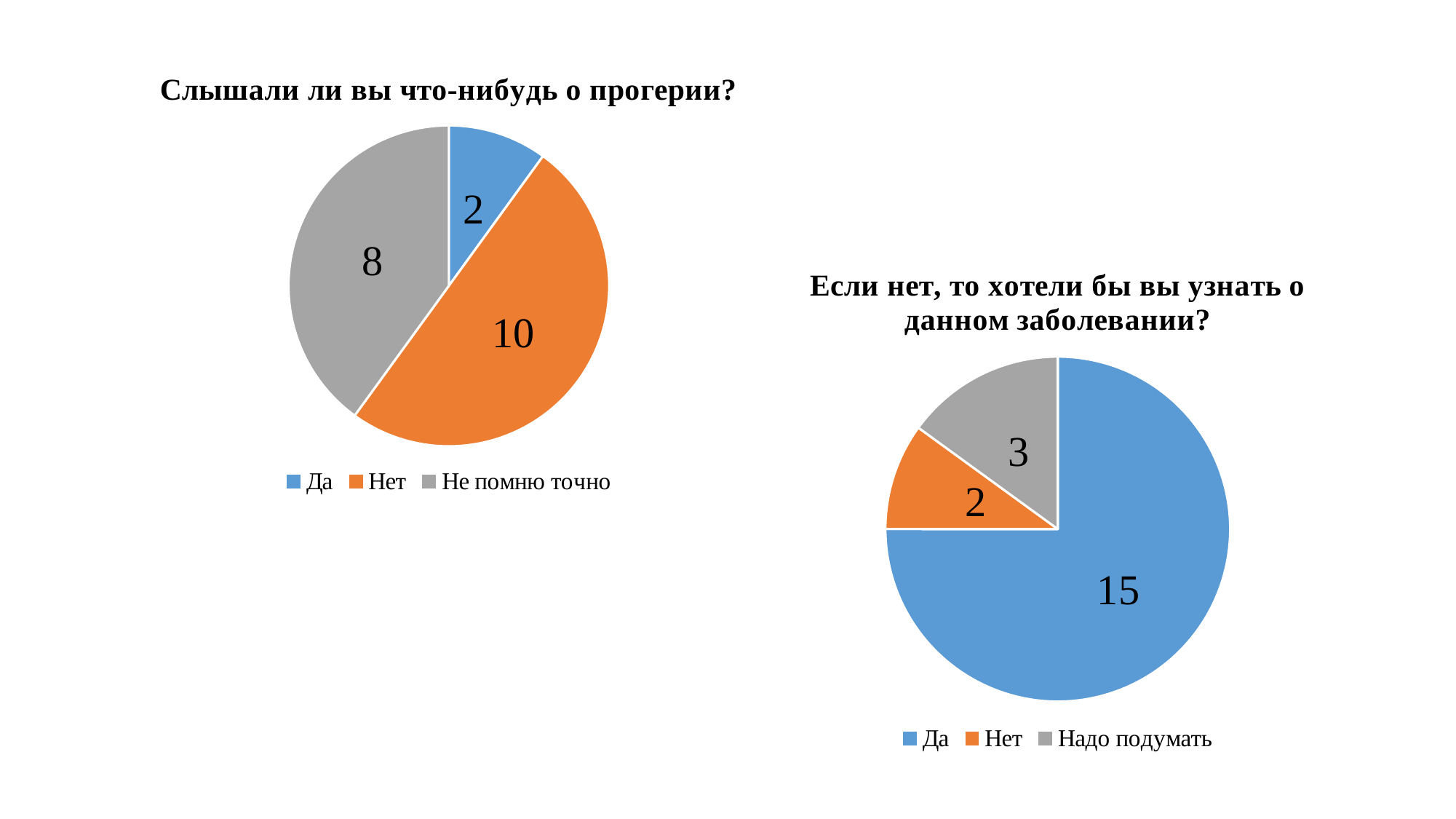
In the right chart titled "Если нет, то хотели бы вы узнать о данном заболевании?", what is the value for "Да"? 15 In the left chart titled "Слышали ли вы что-нибудь о прогерии?", what is the value for "Нет"? 10 What kind of chart is the right chart titled "Если нет, то хотели бы вы узнать о данном заболевании?"? Pie chart In the right chart titled "Если нет, то хотели бы вы узнать о данном заболевании?", which is larger, "Надо подумать" or "Нет"? Надо подумать In the right chart titled "Если нет, то хотели бы вы узнать о данном заболевании?", what is the value for "Надо подумать"? 3 In the left chart titled "Слышали ли вы что-нибудь о прогерии?", what colour is the "Не помню точно" slice? Grey In the left chart titled "Слышали ли вы что-нибудь о прогерии?", which category has the largest slice? Нет In the right chart titled "Если нет, то хотели бы вы узнать о данном заболевании?", which category has the smallest slice? Нет How many categories does the left chart titled "Слышали ли вы что-нибудь о прогерии?" show? 3 In the left chart titled "Слышали ли вы что-нибудь о прогерии?", what is the difference between the values for "Нет" and "Да"? 8 In the left chart titled "Слышали ли вы что-нибудь о прогерии?", what is the value for "Не помню точно"? 8 In the right chart titled "Если нет, то хотели бы вы узнать о данном заболевании?", what share of the total does the "Да" slice represent? 75%